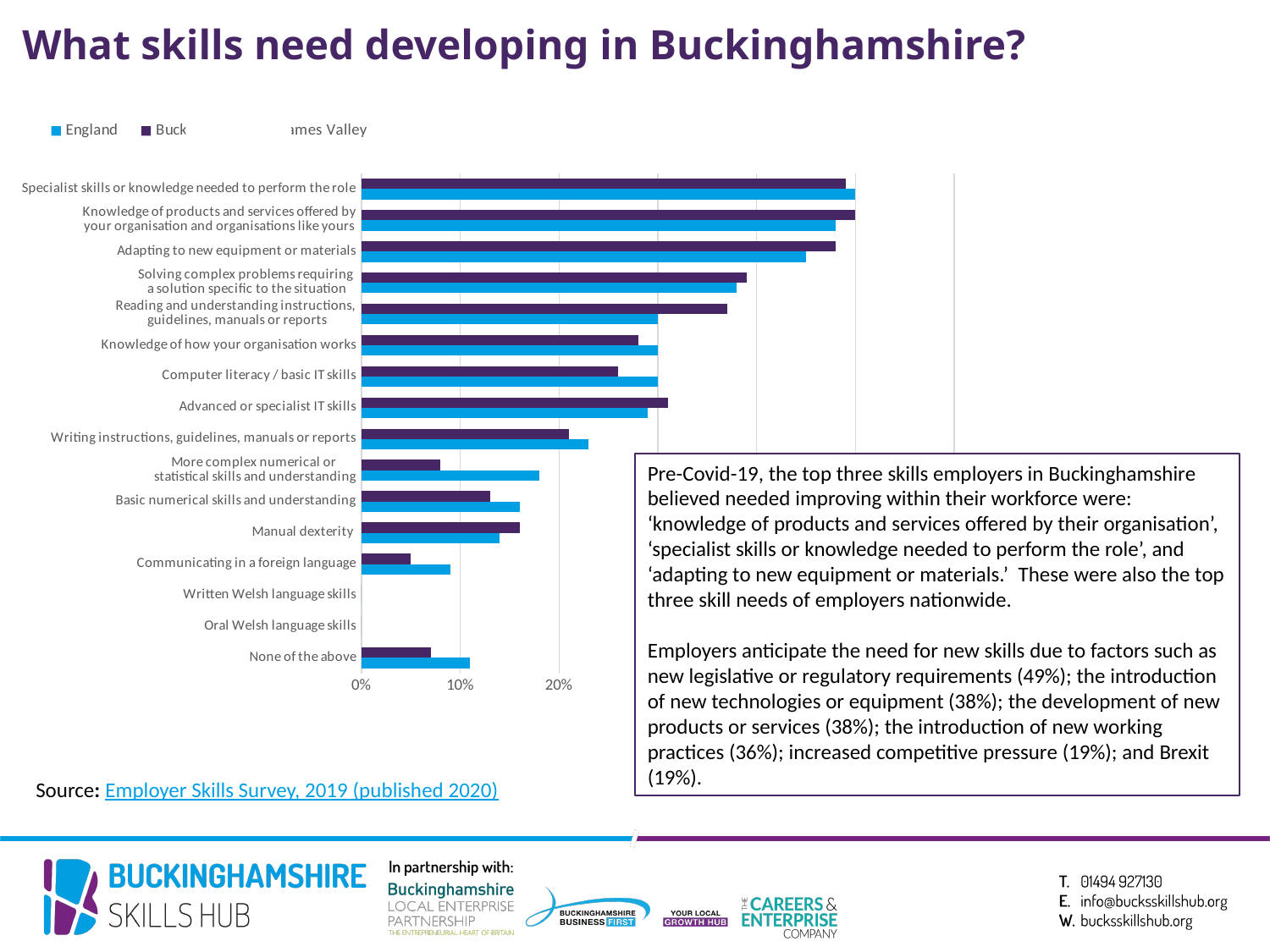
What colour represents the England series in the chart legend? Light blue Is the England value for 'Communicating in a foreign language' greater or less than 10%? less Is the Buck value for 'None of the above' greater or less than 10%? less Is the England value for 'Writing instructions, guidelines, manuals or reports' greater or less than 20%? greater For 'Communicating in a foreign language', which series has the larger value, England or Buck? England What kind of chart is shown on the slide? Bar chart Which two categories show no bars at all on the chart? Written Welsh language skills and Oral Welsh language skills For 'Adapting to new equipment or materials', which series has the larger value, England or Buck? Buck How many skill categories are listed on the chart's vertical axis? 16 For 'More complex numerical or statistical skills and understanding', which series has the larger value, England or Buck? England